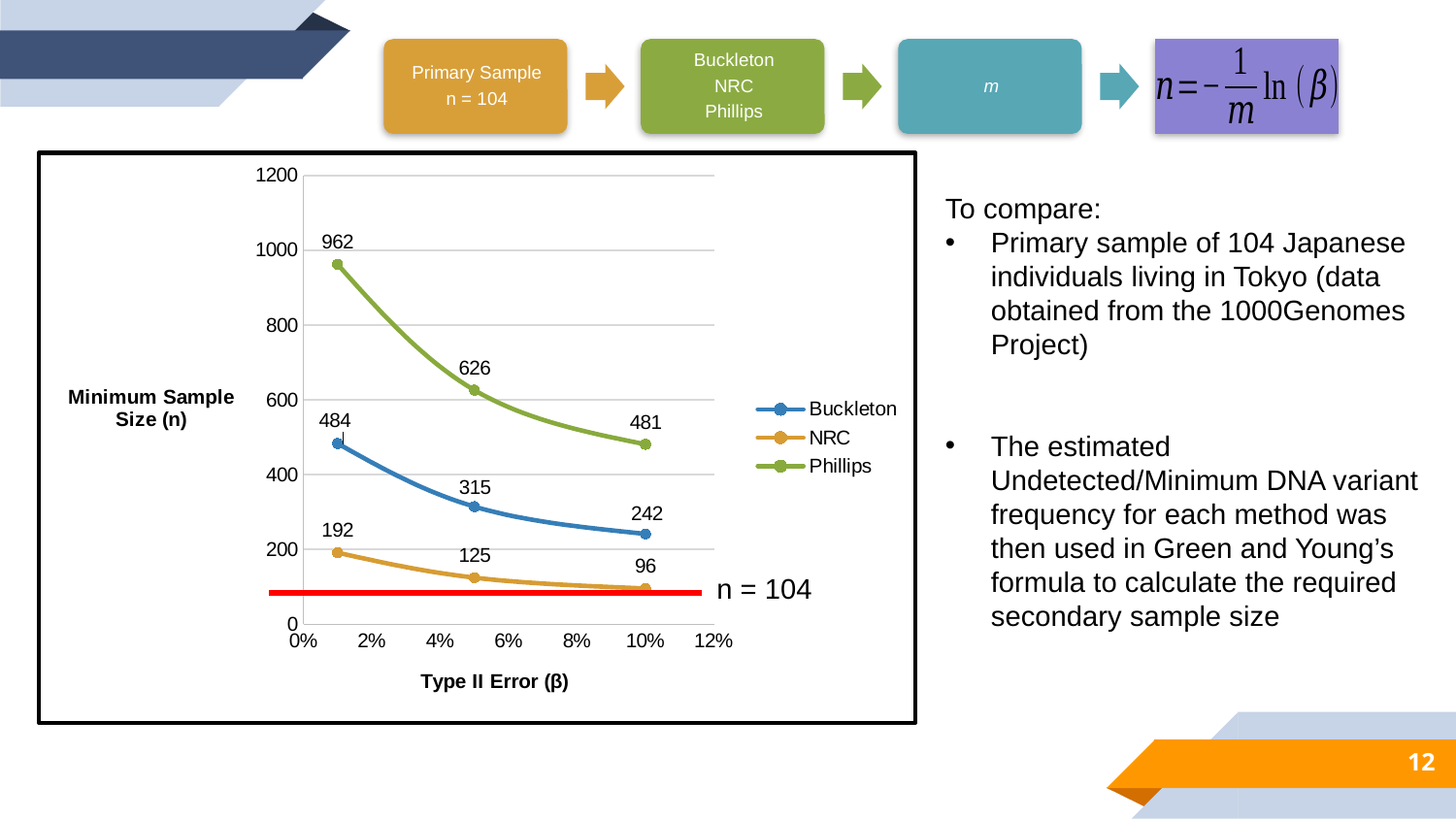
What value does the red horizontal line on the chart represent? n = 104 How many data points are plotted for each series? 3 Which series has the highest minimum sample size at a Type II Error of 1%? Phillips What is the difference between the Phillips and Buckleton values at a Type II Error of 5%? 311 What is the value for NRC at a Type II Error of 5%? 125 Which is larger: the Buckleton value at 1% or the Phillips value at 10%? Buckleton value at 1% How many series does the chart legend list? 3 Which series has the lowest minimum sample size at a Type II Error of 10%? NRC Do the values for each series rise or fall as the Type II Error increases? fall What is the value for Buckleton at a Type II Error of 10%? 242 What kind of chart is shown on the slide? line chart What is the value for Phillips at a Type II Error of 1%? 962